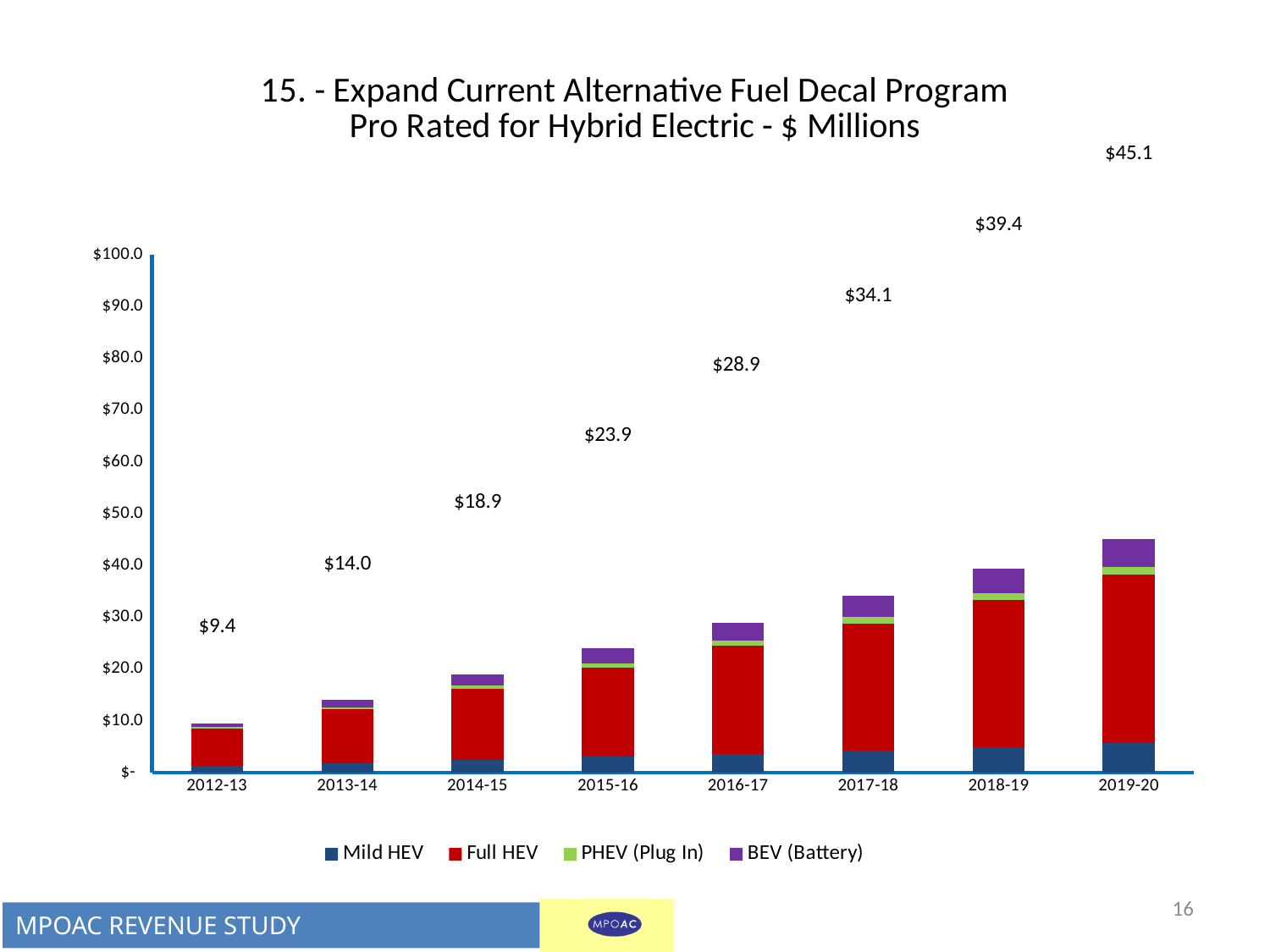
How many series does the legend list? 4 Which year has the highest total value? 2019-20 What is the total value shown for 2015-16? $23.9 What is the difference between the total for 2017-18 and the total for 2012-13? $24.7 Do the total values rise or fall from 2012-13 to 2019-20? rise What is the total value shown for 2019-20? $45.1 What is the total value shown for 2012-13? $9.4 Which year has the lowest total value? 2012-13 Is the total value for 2013-14 greater or less than $20.0? less Which is larger, the total for 2016-17 or the total for 2014-15? 2016-17 What is the difference between the total for 2019-20 and the total for 2018-19? $5.7 How many years are shown on the x axis? 8